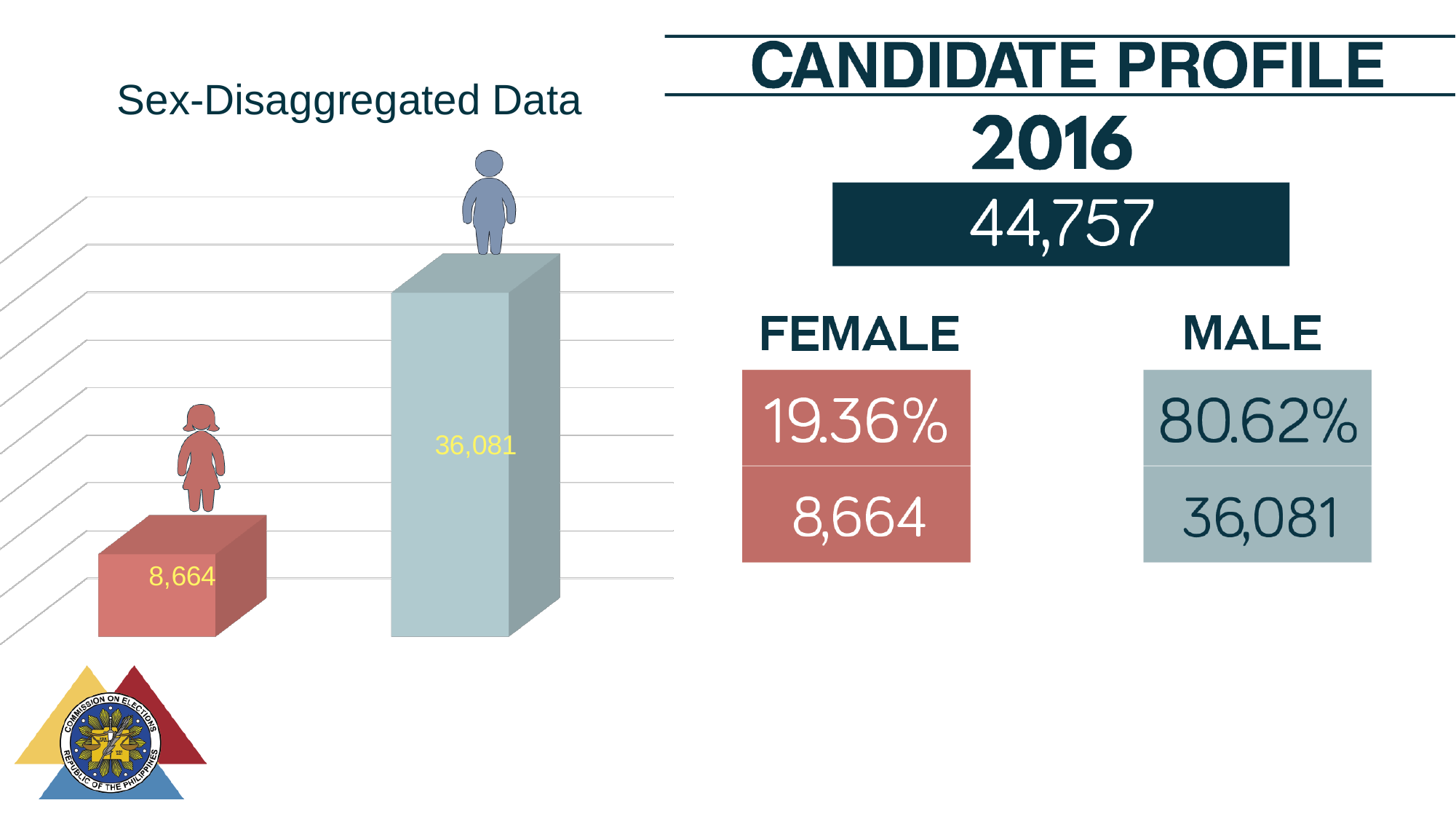
What percentage of candidates does the female bar represent, according to the slide? 19.36% What is the difference between the male bar value and the female bar value? 27,417 Which category has the taller bar, female or male? Male Which category has the shorter bar? Female What is the value of the bar for male candidates? 36,081 What is the title of the chart? Sex-Disaggregated Data Is the female bar value larger or smaller than the male bar value? Smaller What kind of chart is shown on the slide? Bar chart How many bars are plotted in the chart? 2 What percentage of candidates does the male bar represent, according to the slide? 80.62% What is the total of the female and male bar values? 44,745 What is the value of the bar for female candidates? 8,664